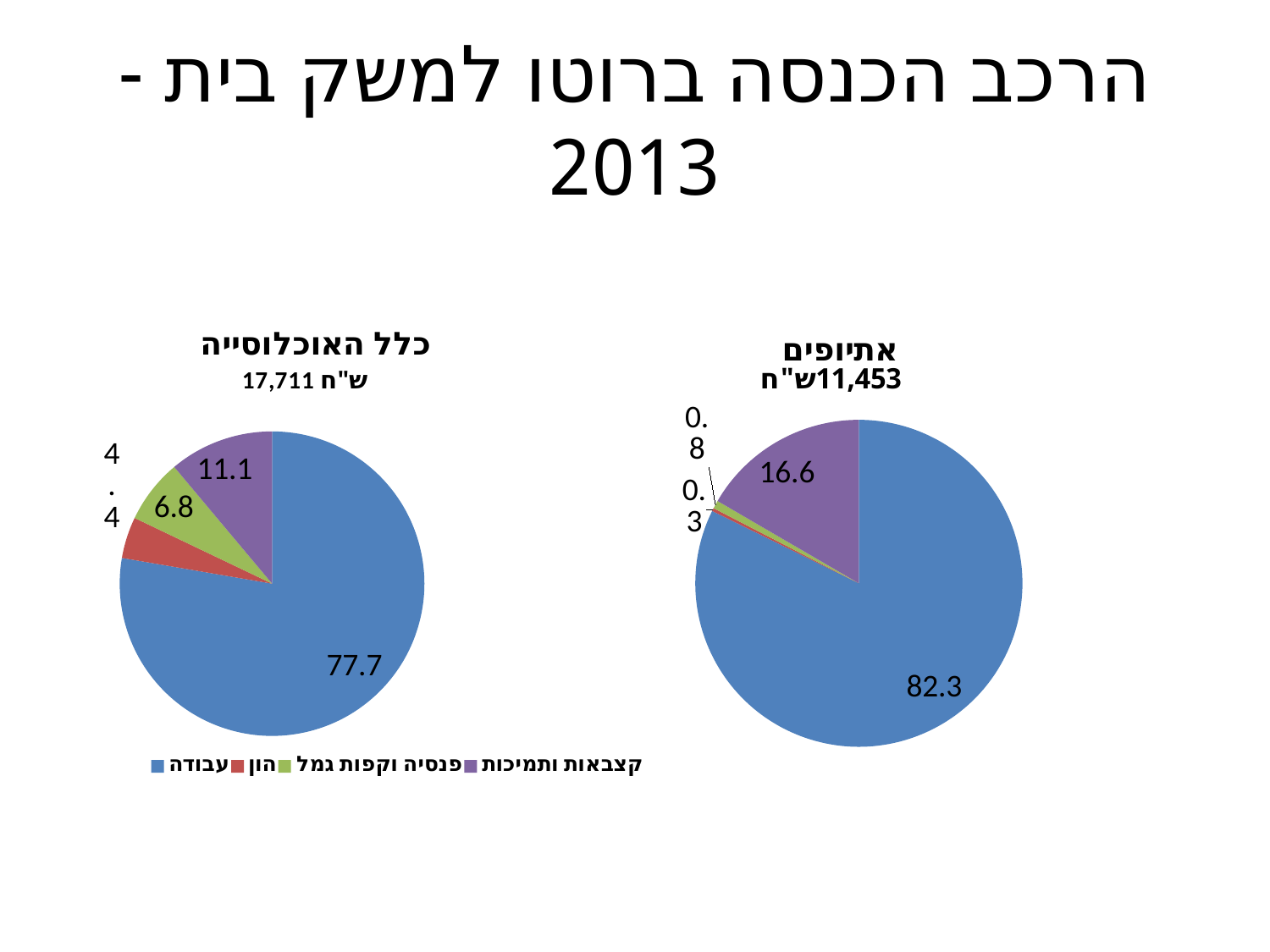
How many entries does the legend list? 4 What is the difference between the עבודה value in the right chart (אתיופים) and the עבודה value in the left chart (כלל האוכלוסייה)? 4.6 In the left pie chart (כלל האוכלוסייה), what is the value for הון? 4.4 What kind of charts are shown on the slide? Pie charts In the left pie chart (כלל האוכלוסייה), what is the value for עבודה? 77.7 In the left pie chart (כלל האוכלוסייה), what is the value for קצבאות ותמיכות? 11.1 In the right pie chart (אתיופים), what is the value for קצבאות ותמיכות? 16.6 In the left pie chart (כלל האוכלוסייה), what is the value for פנסיה וקופות גמל? 6.8 Which chart shows a larger value for קצבאות ותמיכות, the left (כלל האוכלוסייה) or the right (אתיופים)? אתיופים In the right pie chart (אתיופים), what is the value for עבודה? 82.3 In the left pie chart (כלל האוכלוסייה), which category has the smallest share? הון In the left pie chart (כלל האוכלוסייה), which category has the largest share? עבודה